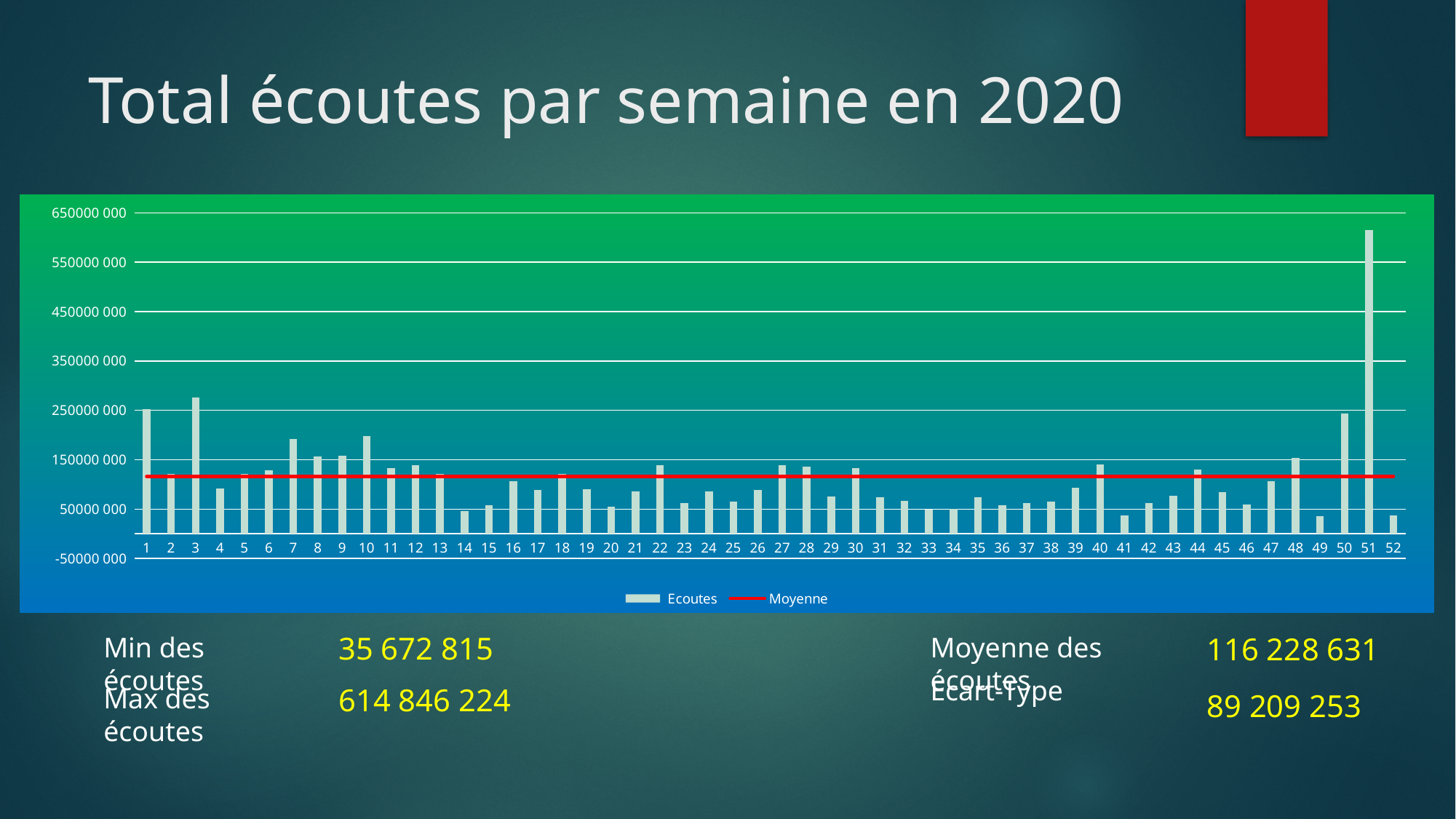
According to the slide, what is the value of the Moyenne line (average écoutes)? 116 228 631 What is the title of the slide? Total écoutes par semaine en 2020 How many series does the chart legend list? 2 Which is larger, the value for week 50 or the value for week 49? week 50 Is the value for week 7 greater or less than 150000 000? greater Which is larger, the value for week 3 or the value for week 1? week 3 What kind of chart is shown on the slide? combination bar and line chart How many weeks (categories) are plotted on the x axis? 52 Is the value for week 51 greater or less than 550000 000? greater Which week has the highest number of écoutes? 51 According to the slide, what is the maximum weekly écoutes value? 614 846 224